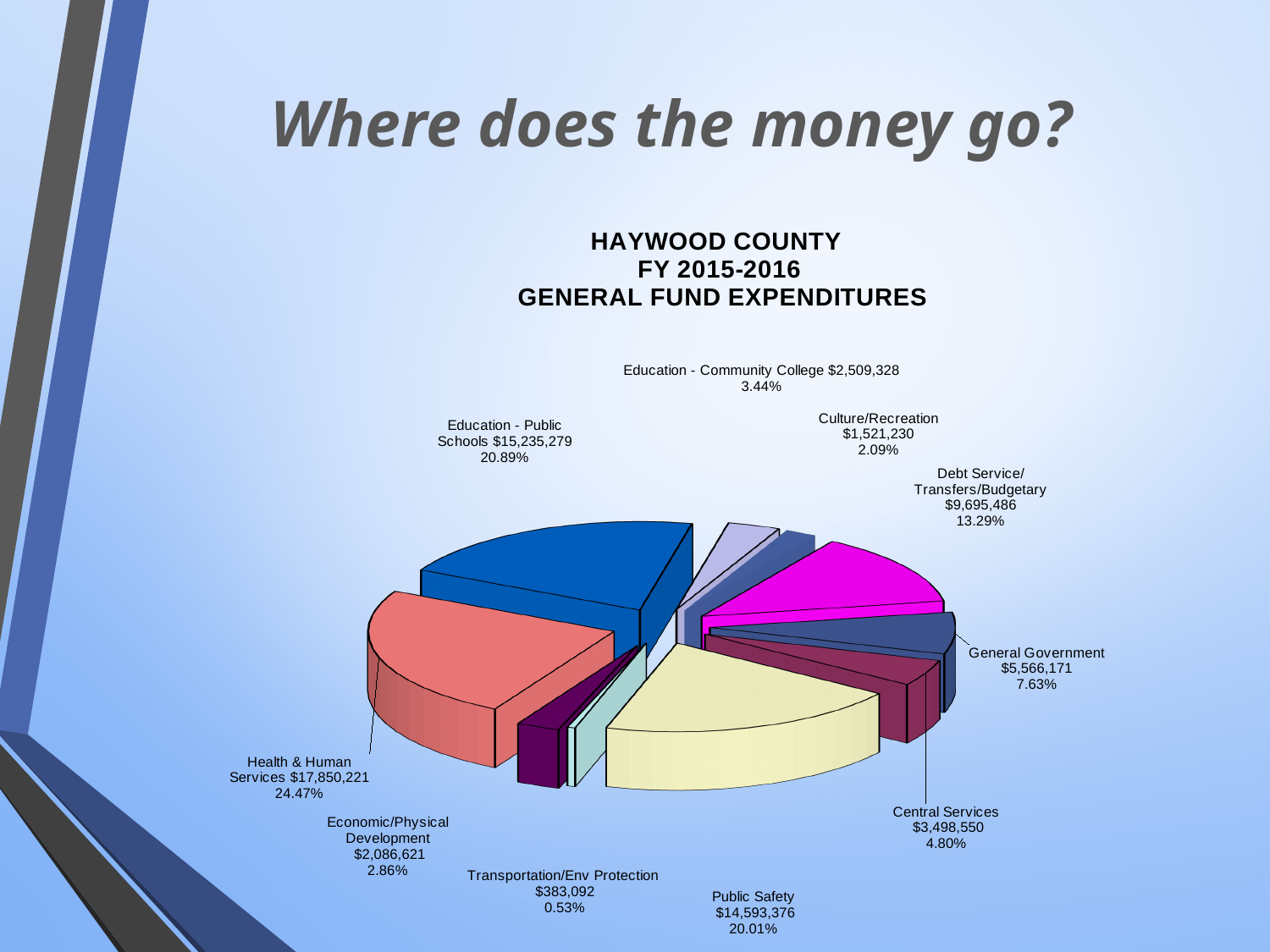
Which category has the largest share of expenditures? Health & Human Services What is the dollar amount for Health & Human Services? $17,850,221 What is the dollar amount for Debt Service/Transfers/Budgetary? $9,695,486 What type of chart is shown on the slide? Pie chart What fiscal year does the chart title refer to? FY 2015-2016 What is the difference in dollars between Health & Human Services and Education - Public Schools? $2,614,942 Which category has the smallest share of expenditures? Transportation/Env Protection What percentage of general fund expenditures goes to Public Safety? 20.01% What is the dollar amount for Culture/Recreation? $1,521,230 What percentage share does Central Services have? 4.80% Which is larger, Education - Public Schools or Public Safety? Education - Public Schools How many categories are shown in the pie chart? 10